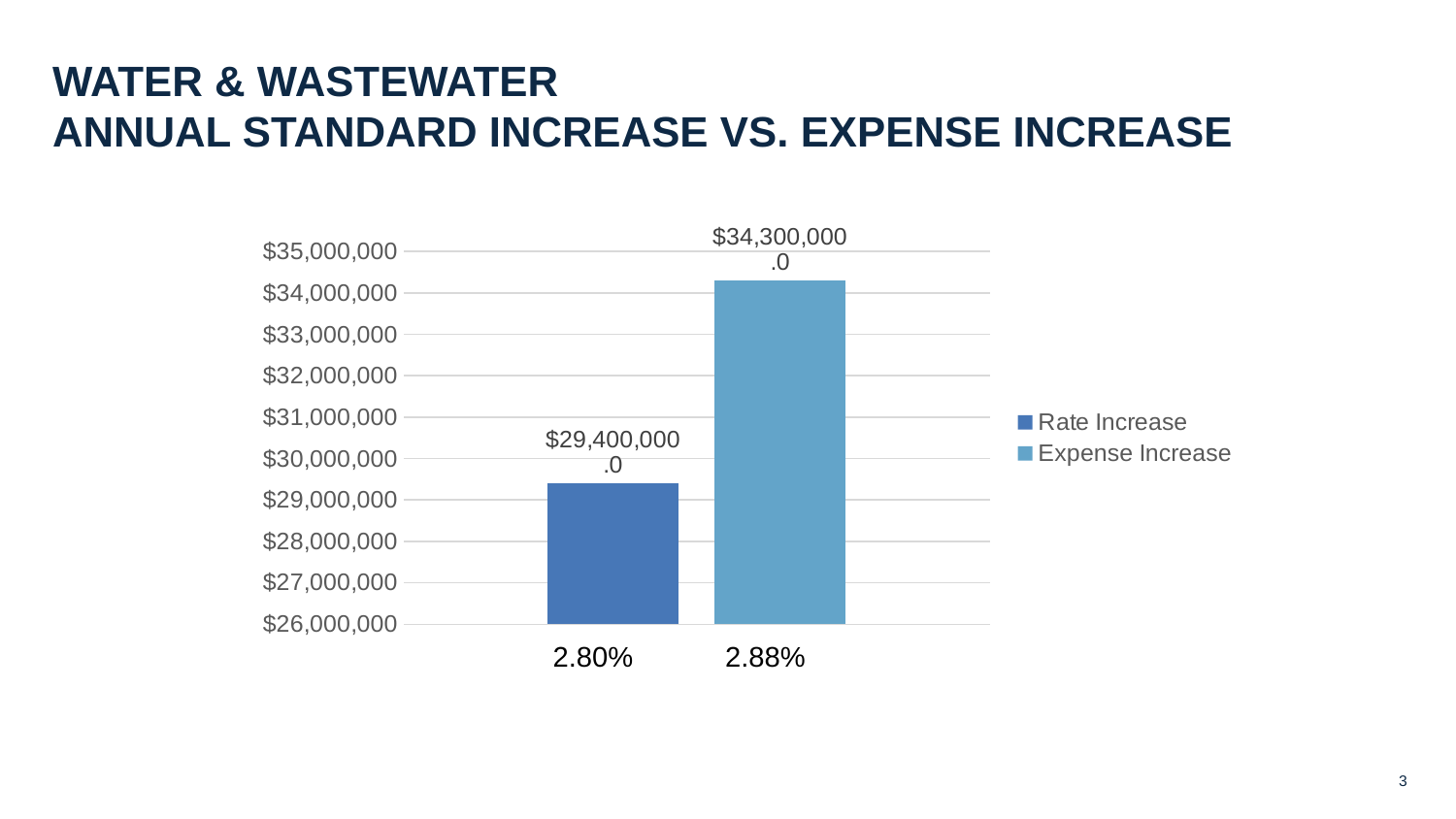
Which bar is the lowest in the chart? Rate Increase How many series does the legend list? 2 Is the value for Rate Increase greater or less than $30,000,000? less What is the difference between the Expense Increase value and the Rate Increase value? $4,900,000.0 What is the value of the Rate Increase bar? $29,400,000.0 Which series has the higher value, Rate Increase or Expense Increase? Expense Increase What percentage label appears under the Expense Increase bar? 2.88% What is the value of the Expense Increase bar? $34,300,000.0 Is the value for Expense Increase greater or less than $34,000,000? greater What kind of chart is shown on the slide? Bar chart How many bars are plotted in the chart? 2 What percentage label appears under the Rate Increase bar? 2.80%